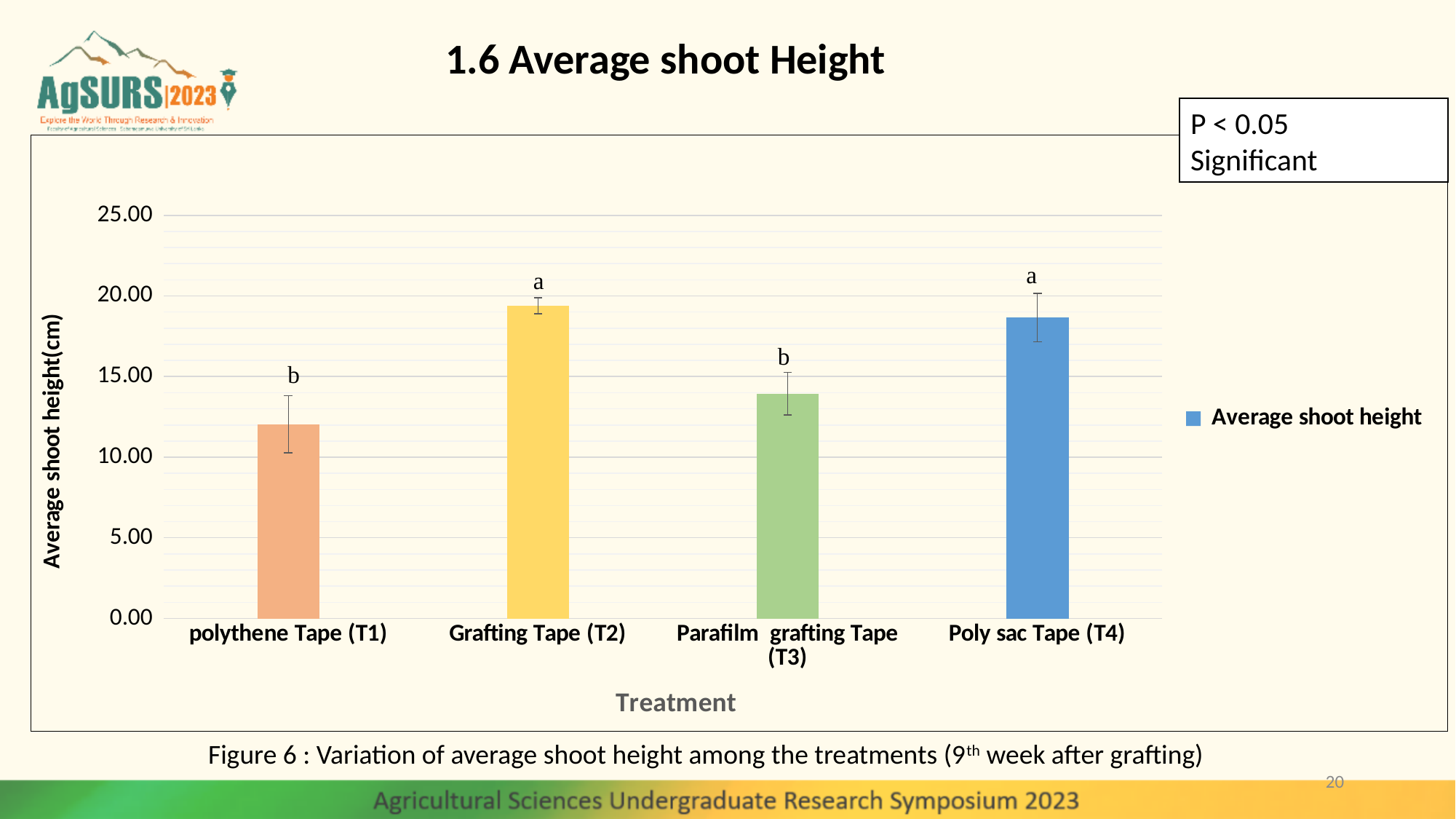
Is the value for polythene Tape (T1) greater or less than 15.00? less What kind of chart is shown on the slide? bar chart What is the title of the y axis? Average shoot height(cm) Which is larger, the average shoot height for Poly sac Tape (T4) or for Parafilm grafting Tape (T3)? Poly sac Tape (T4) Is the value for Grafting Tape (T2) greater or less than 15.00? greater Which is larger, the average shoot height for Grafting Tape (T2) or for polythene Tape (T1)? Grafting Tape (T2) Is the value for Poly sac Tape (T4) greater or less than 15.00? greater What series name is shown in the legend? Average shoot height How many series does the legend list? 1 How many treatments are plotted on the x axis? 4 Which treatment has the lowest average shoot height? polythene Tape (T1)